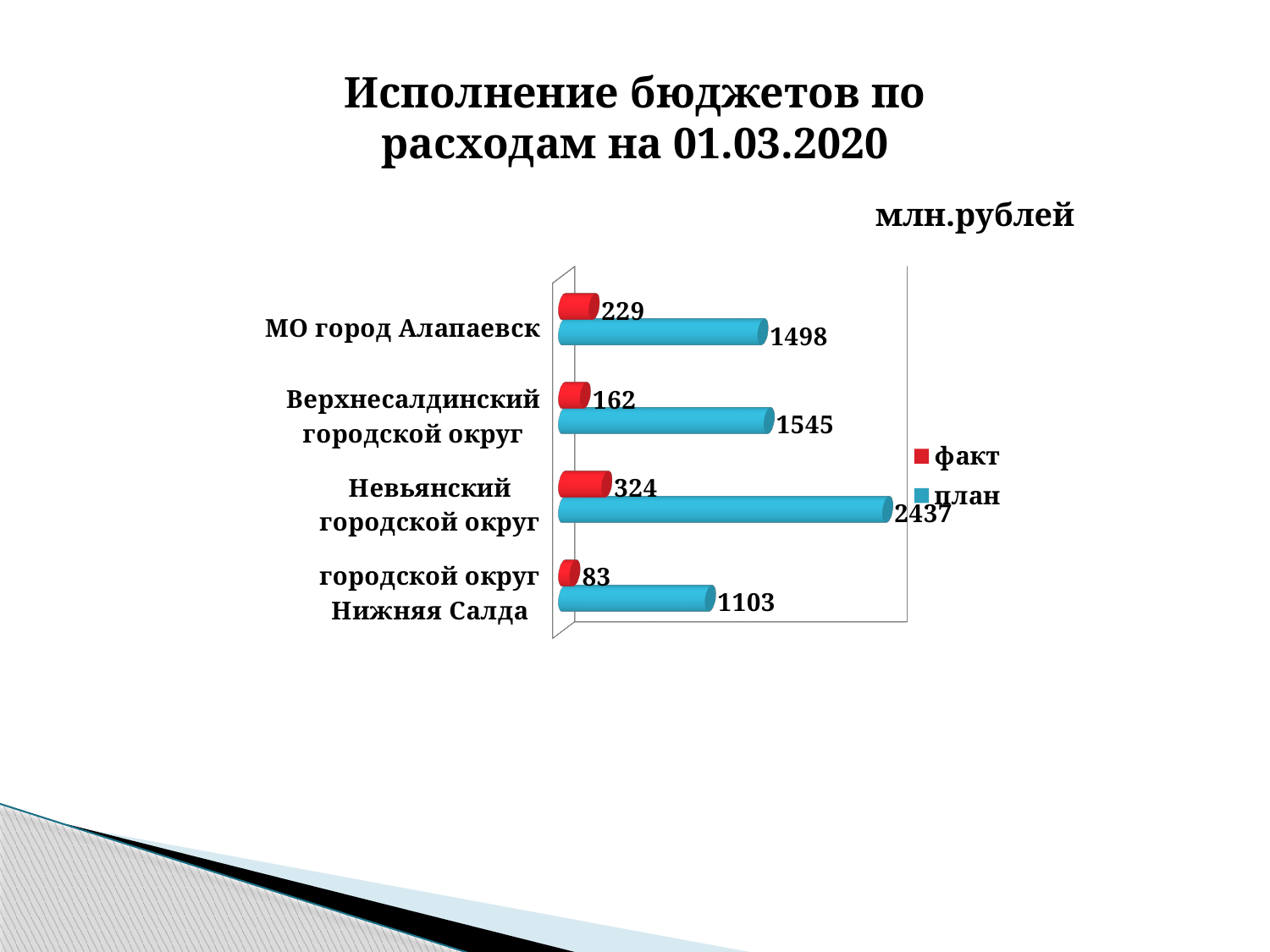
What is the факт value for МО город Алапаевск? 229 Which category has the highest план value? Невьянский городской округ What kind of chart is shown on the slide? Bar chart What is the план value for городской округ Нижняя Салда? 1103 Which category has the lowest факт value? городской округ Нижняя Салда What is the факт value for Верхнесалдинский городской округ? 162 What is the difference between the план and факт values for Невьянский городской округ? 2113 What unit is stated above the chart? млн.рублей Which is larger, the план value for МО город Алапаевск or for Верхнесалдинский городской округ? Верхнесалдинский городской округ How many series does the legend list? 2 How many categories are shown in the chart? 4 What is the план value for Невьянский городской округ? 2437